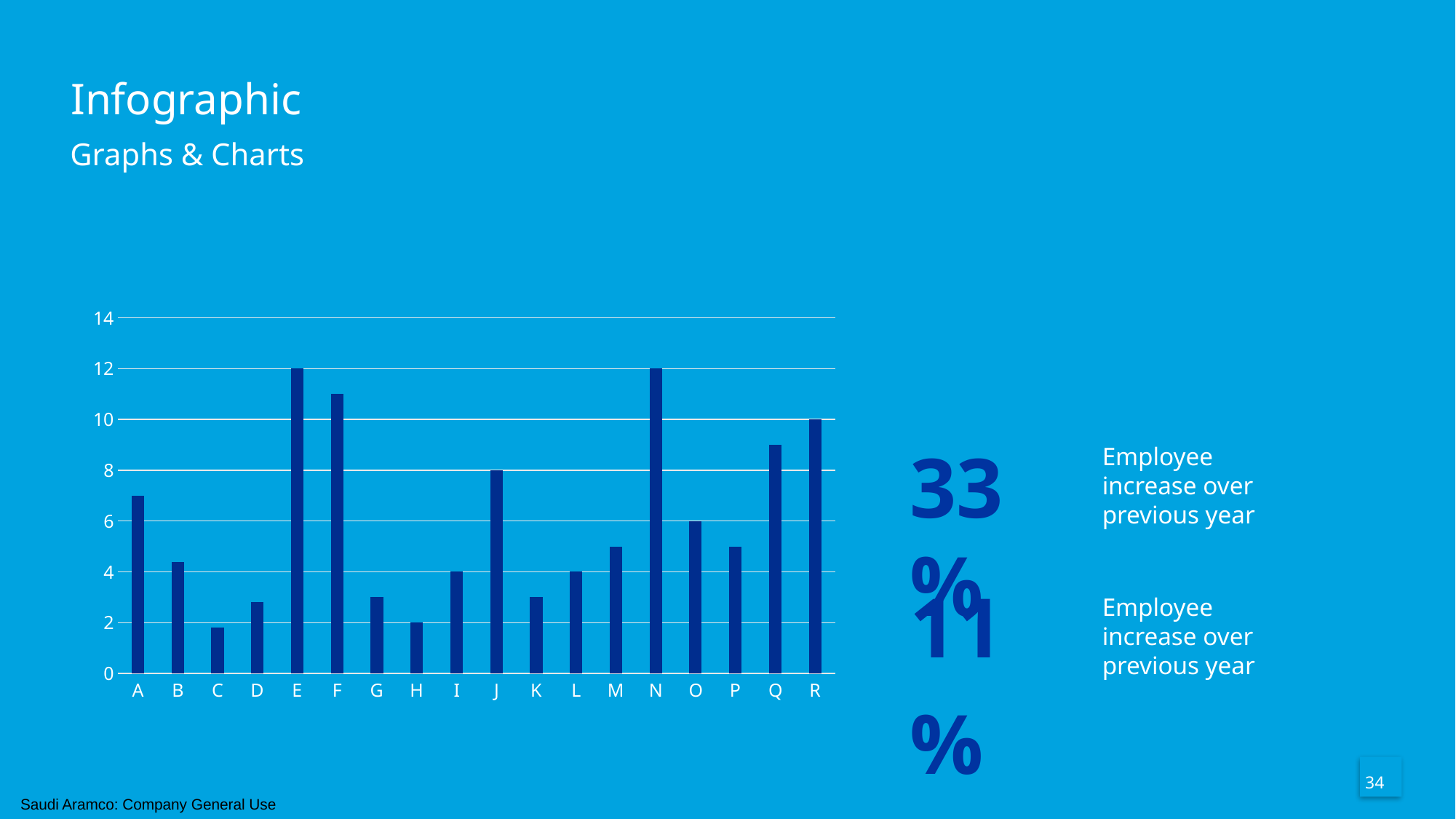
What is the value for category J? 8 What kind of chart is shown on the slide? bar chart What is the value for category O? 6 Is the value for category D greater or less than 4? less Which is larger, the value for category F or the value for category J? F What is the difference between the values for categories E and J? 4 What is the difference between the values for categories N and O? 6 Is the value for category A greater or less than 6? greater How many categories are shown on the x axis of the bar chart? 18 What is the value for category E? 12 What is the value for category R? 10 Is the value for category Q greater or less than 8? greater